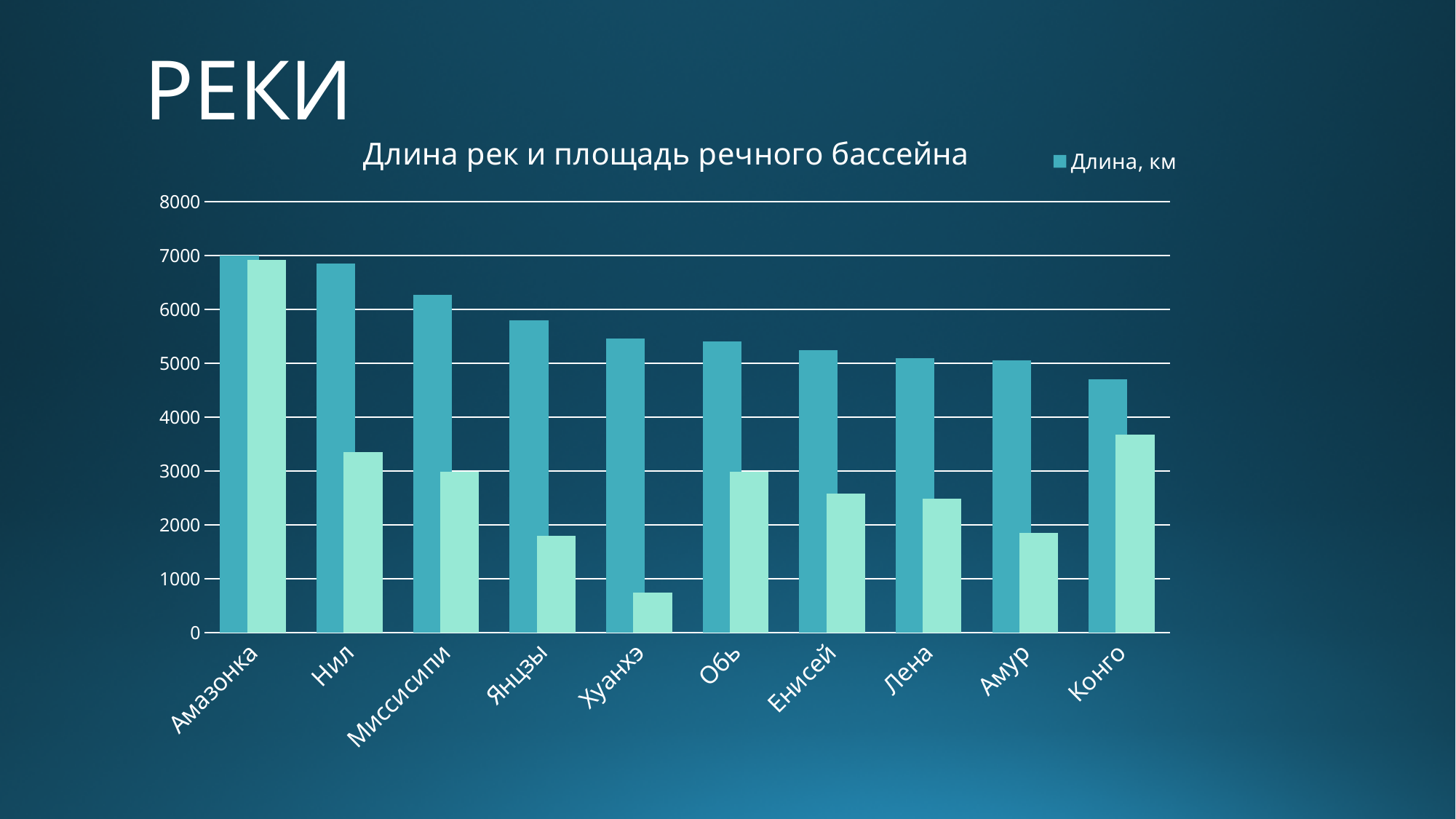
Which river has the highest value in the Длина, км series? Амазонка Which is larger, the Длина, км value for Нил or for Конго? Нил Is the Длина, км value for Конго greater or less than 5000? less Which river has the lowest value in the Длина, км series? Конго Is the Длина, км value for Хуанхэ greater or less than 5000? greater Do the Длина, км values rise or fall from Амазонка to Конго along the x axis? fall Is the Длина, км value for Нил greater or less than 6000? greater How many series does the chart's legend list? 1 What kind of chart is shown on the slide? bar chart How many rivers are shown on the x axis of the chart? 10 What is the title of the chart? Длина рек и площадь речного бассейна